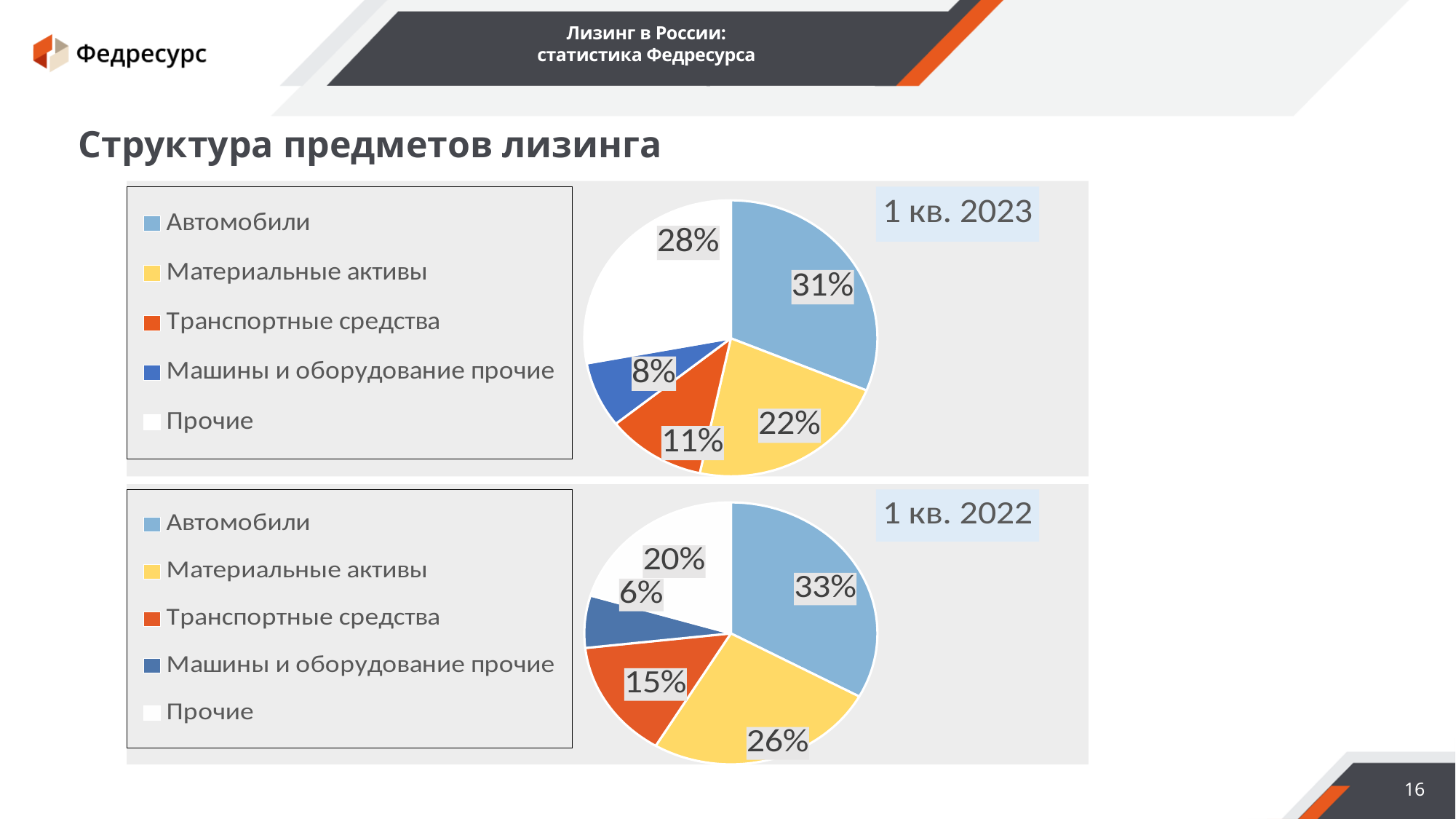
Which is larger: the share of 'Прочие' in the '1 кв. 2023' chart or in the '1 кв. 2022' chart? 1 кв. 2023 In the '1 кв. 2022' pie chart, what share does 'Транспортные средства' have? 15% In the '1 кв. 2022' pie chart, what share does 'Машины и оборудование прочие' have? 6% In the '1 кв. 2023' pie chart, what share does 'Прочие' have? 28% In the '1 кв. 2023' pie chart, which category has the smallest share? Машины и оборудование прочие In the '1 кв. 2022' pie chart, what is the difference in percentage points between 'Автомобили' and 'Материальные активы'? 7 How many categories does the '1 кв. 2022' pie chart show? 5 In the '1 кв. 2022' pie chart, which category has the smallest share? Машины и оборудование прочие In the '1 кв. 2023' pie chart, what share does 'Автомобили' have? 31% What type of chart is used for '1 кв. 2023'? Pie chart In the '1 кв. 2023' pie chart, which category has the largest share? Автомобили What colour represents 'Материальные активы' in the legends? Yellow